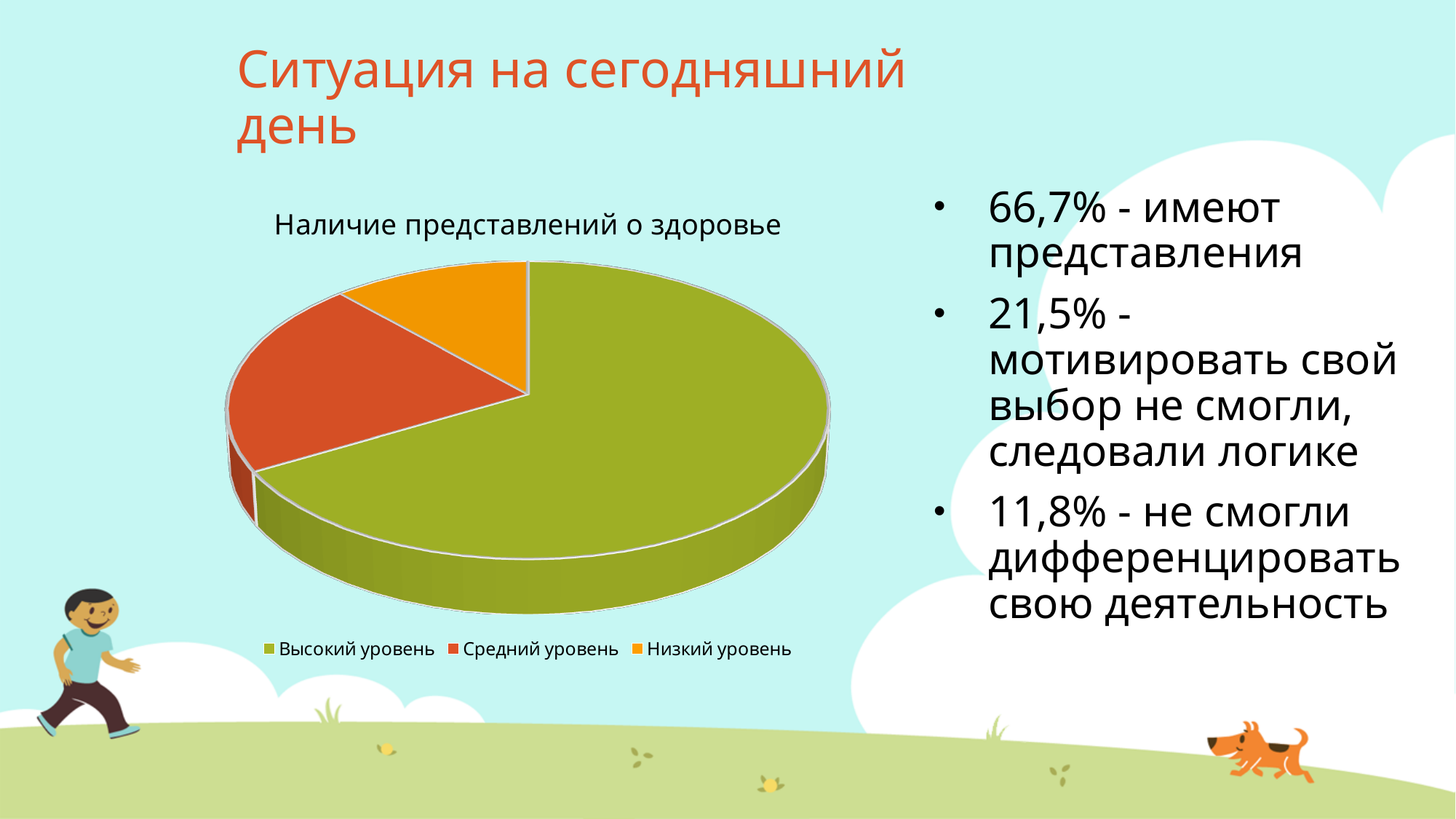
Which colour represents Низкий уровень in the chart? orange What kind of chart is shown on the slide? pie chart Which slice is larger: Средний уровень or Низкий уровень? Средний уровень Which category has the smallest slice of the pie? Низкий уровень Which slice is larger: Высокий уровень or Средний уровень? Высокий уровень How many slices does the pie chart have? 3 How many entries does the chart legend list? 3 Which category has the largest slice of the pie? Высокий уровень Does the Высокий уровень slice take up more or less than half of the pie? more What is the title of the chart? Наличие представлений о здоровье